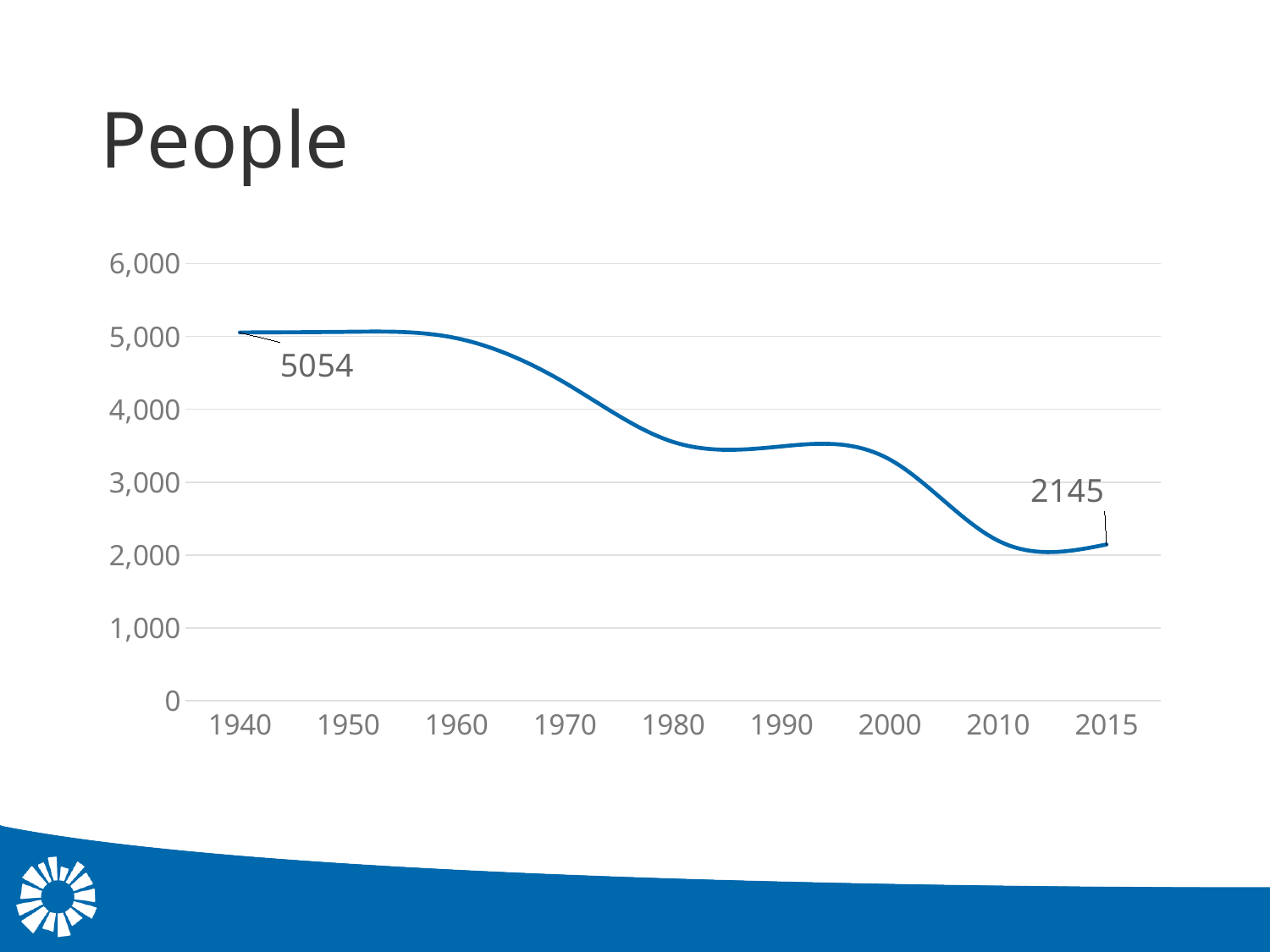
What is the value for 1940? 5054 Is the value for 2010 greater or less than 3,000? less What kind of chart is shown on the slide? line chart Do the values generally rise or fall from 1940 to 2015? fall Is the value for 1960 greater or less than 4,000? greater Is the value for 1980 greater or less than 4,000? less Which is larger, the value for 1960 or the value for 1990? 1960 What is the value for 2015? 2145 What is the difference between the values for 1940 and 2015? 2909 Which is larger, the value for 1940 or the value for 2015? 1940 What is the title of the chart? People